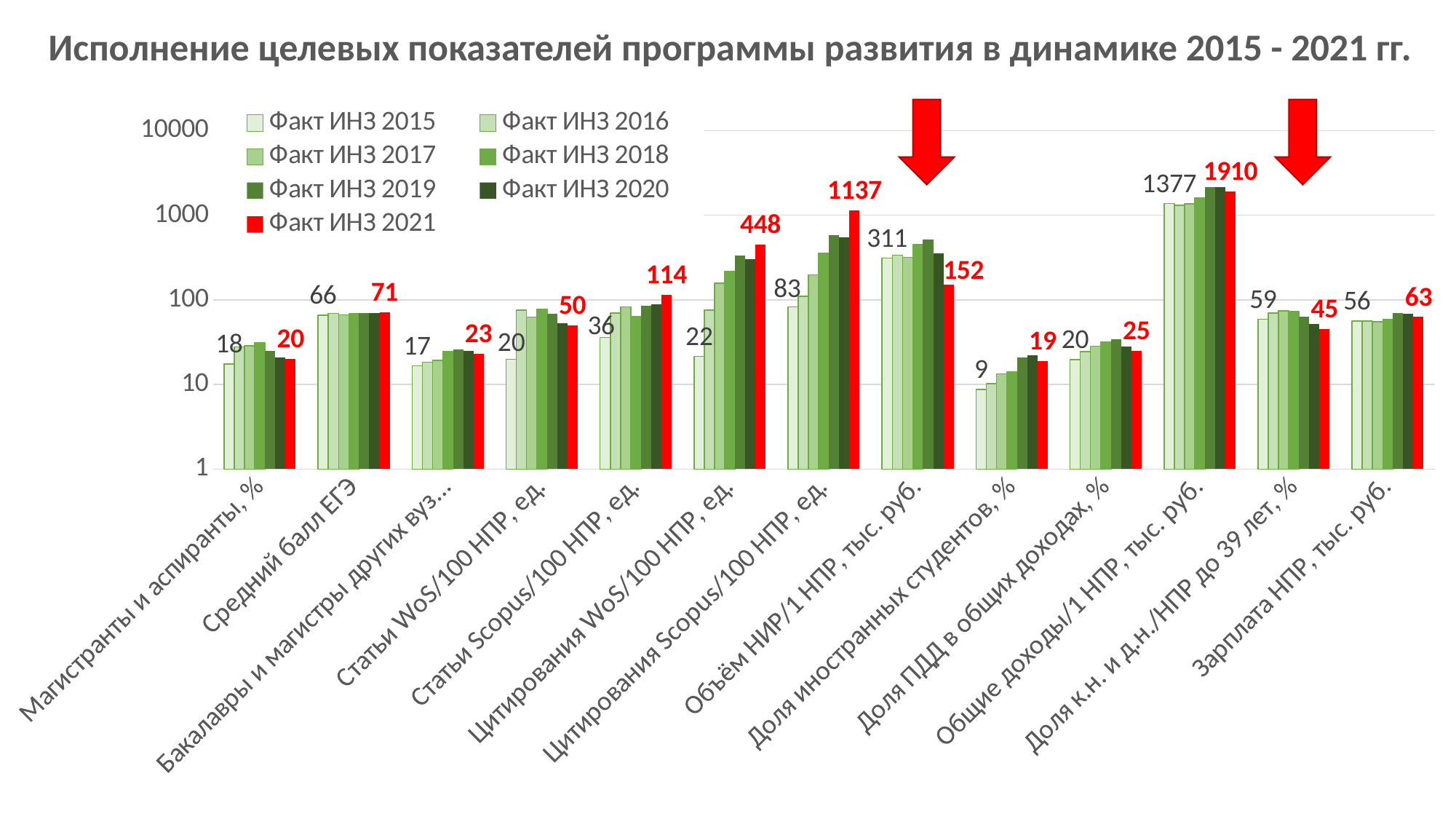
Which category has the lowest Факт ИНЗ 2015 value? Доля иностранных студентов, % What is the difference between the Факт ИНЗ 2021 and Факт ИНЗ 2015 values for Средний балл ЕГЭ? 5 What is the title of the chart? Исполнение целевых показателей программы развития в динамике 2015 - 2021 гг. Is the Факт ИНЗ 2018 value for Цитирования Scopus/100 НПР, ед. greater or less than 100? greater What is the Факт ИНЗ 2021 value for Цитирования Scopus/100 НПР, ед.? 1137 Which is larger for Доля к.н. и д.н./НПР до 39 лет, %: the Факт ИНЗ 2015 value or the Факт ИНЗ 2021 value? Факт ИНЗ 2015 How many categories are shown along the x axis? 13 What kind of chart is shown on the slide? bar chart Which category has the highest Факт ИНЗ 2021 value? Общие доходы/1 НПР, тыс. руб. What is the Факт ИНЗ 2021 value for Общие доходы/1 НПР, тыс. руб.? 1910 How many series does the legend list? 7 What is the Факт ИНЗ 2015 value for Объём НИР/1 НПР, тыс. руб.? 311